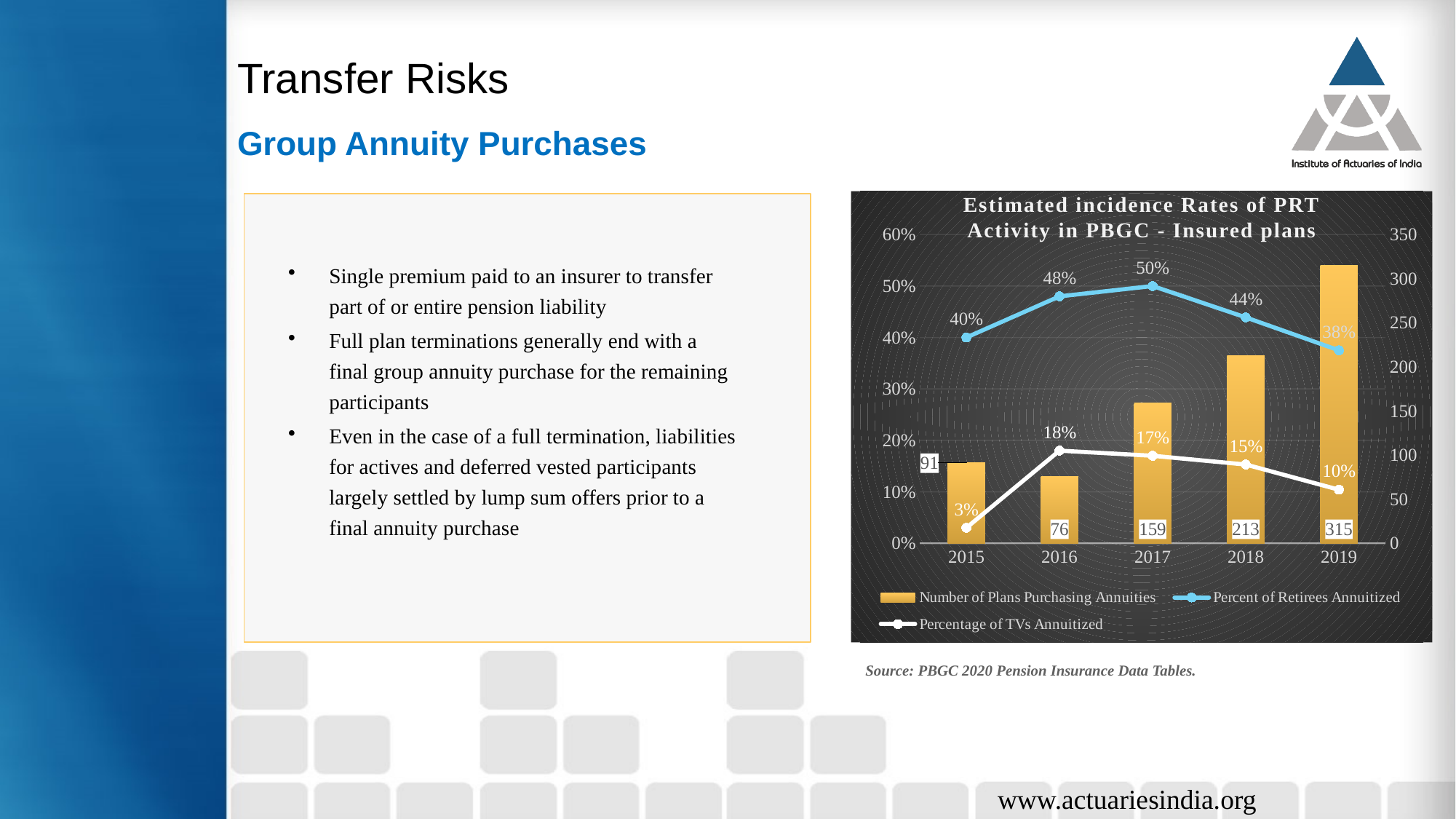
Does the Percent of Retirees Annuitized rise or fall from 2017 to 2019? fall What is the Percentage of TVs Annuitized in 2015? 3% What is the Number of Plans Purchasing Annuities in 2019? 315 Which year has the highest Percent of Retirees Annuitized? 2017 Which is larger: the Percentage of TVs Annuitized in 2016 or in 2019? 2016 What is the difference in the Number of Plans Purchasing Annuities between 2019 and 2018? 102 What is the title of the chart? Estimated incidence Rates of PRT Activity in PBGC - Insured plans What is the difference between the Percent of Retirees Annuitized and the Percentage of TVs Annuitized in 2018? 29% How many years are shown on the x axis of the chart? 5 How many series does the chart legend list? 3 Which year has the lowest Number of Plans Purchasing Annuities? 2016 What is the Percent of Retirees Annuitized in 2017? 50%